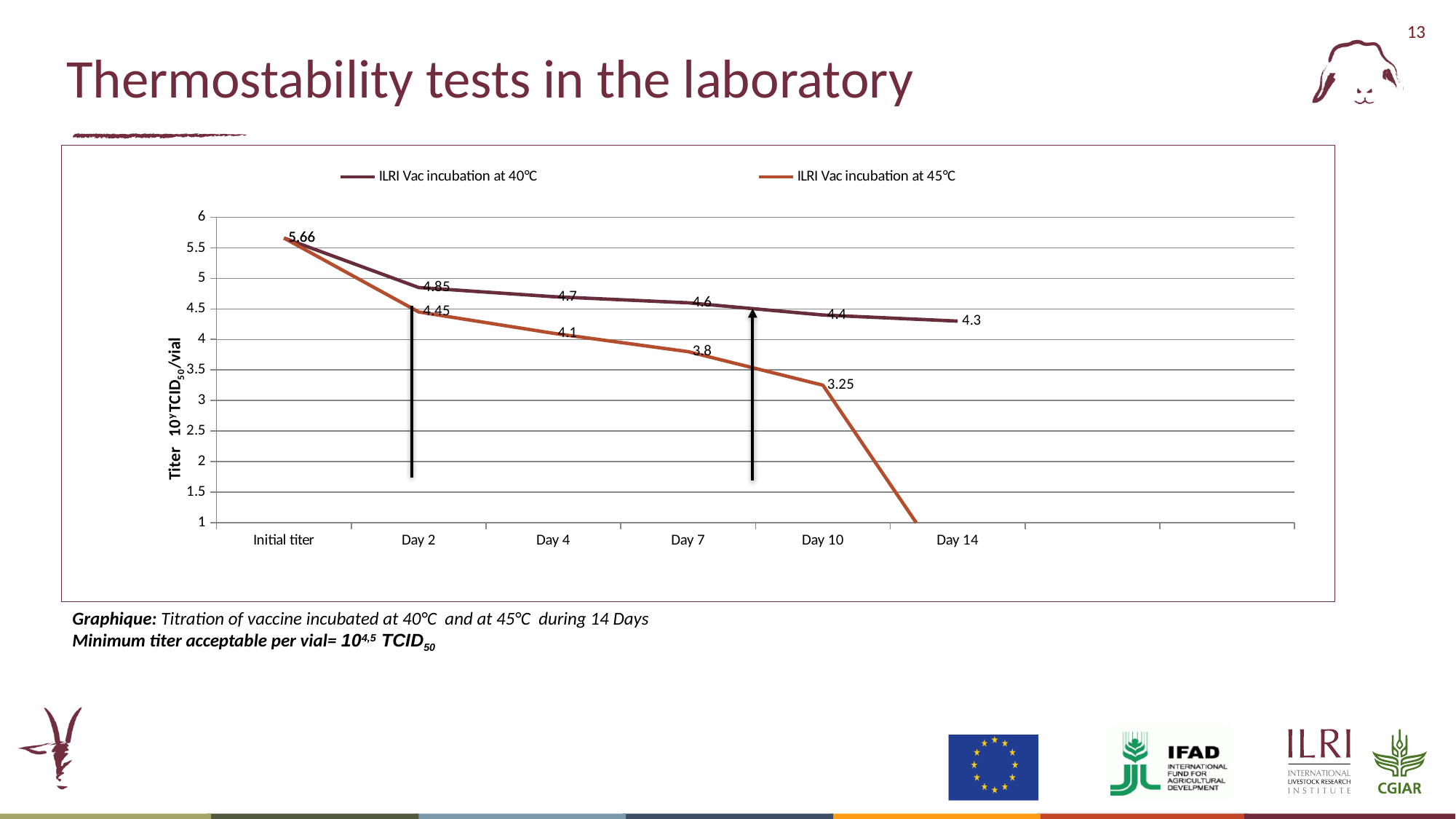
What is the label of the y axis? Titer 10^y TCID50/vial Do the values for ILRI Vac incubation at 45°C rise or fall from Initial titer to Day 10? fall What is the value for ILRI Vac incubation at 45°C at Day 7? 3.8 What is the value for ILRI Vac incubation at 40°C at Day 2? 4.85 What kind of chart is shown on the slide? line chart What is the difference between the 40°C and 45°C values at Day 4? 0.6 How many categories are shown on the x axis? 6 How many series does the legend list? 2 Which series has the larger value at Day 10, ILRI Vac incubation at 40°C or at 45°C? ILRI Vac incubation at 40°C Is the value for ILRI Vac incubation at 45°C at Day 14 greater or less than 2? less What is the value for ILRI Vac incubation at 45°C at Day 10? 3.25 What is the value for ILRI Vac incubation at 40°C at Day 14? 4.3